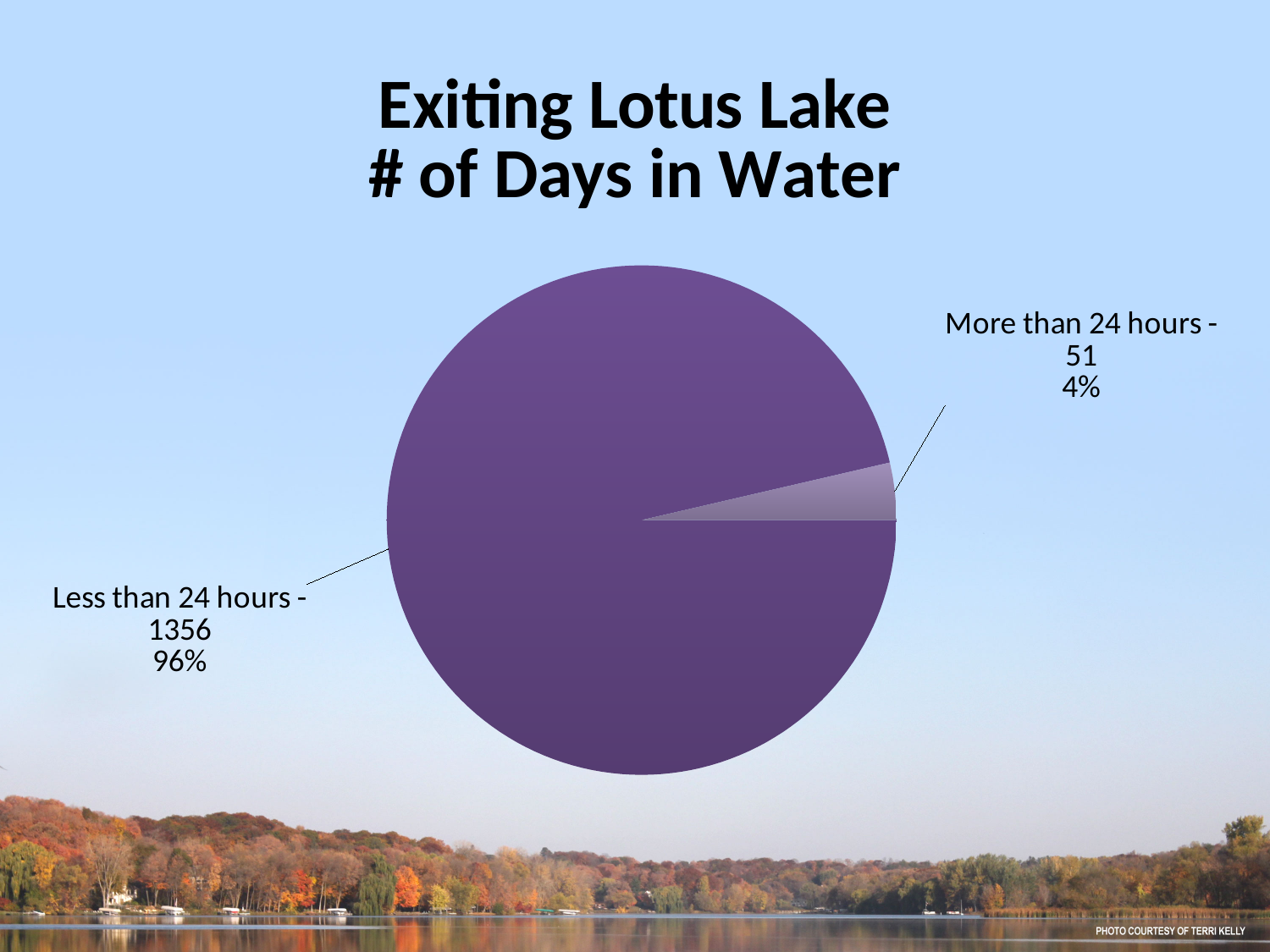
What share of the pie does "More than 24 hours" represent? 4% What is the difference between the values for "Less than 24 hours" and "More than 24 hours"? 1305 What kind of chart is shown on the slide? pie chart What is the total of the two slice values? 1407 Which is larger, the value for "Less than 24 hours" or "More than 24 hours"? Less than 24 hours What is the value for "Less than 24 hours"? 1356 How many slices does the pie chart have? 2 What share of the pie does "Less than 24 hours" represent? 96% Which category has the largest slice? Less than 24 hours What is the title of the chart? Exiting Lotus Lake # of Days in Water Which category has the smallest slice? More than 24 hours What is the value for "More than 24 hours"? 51